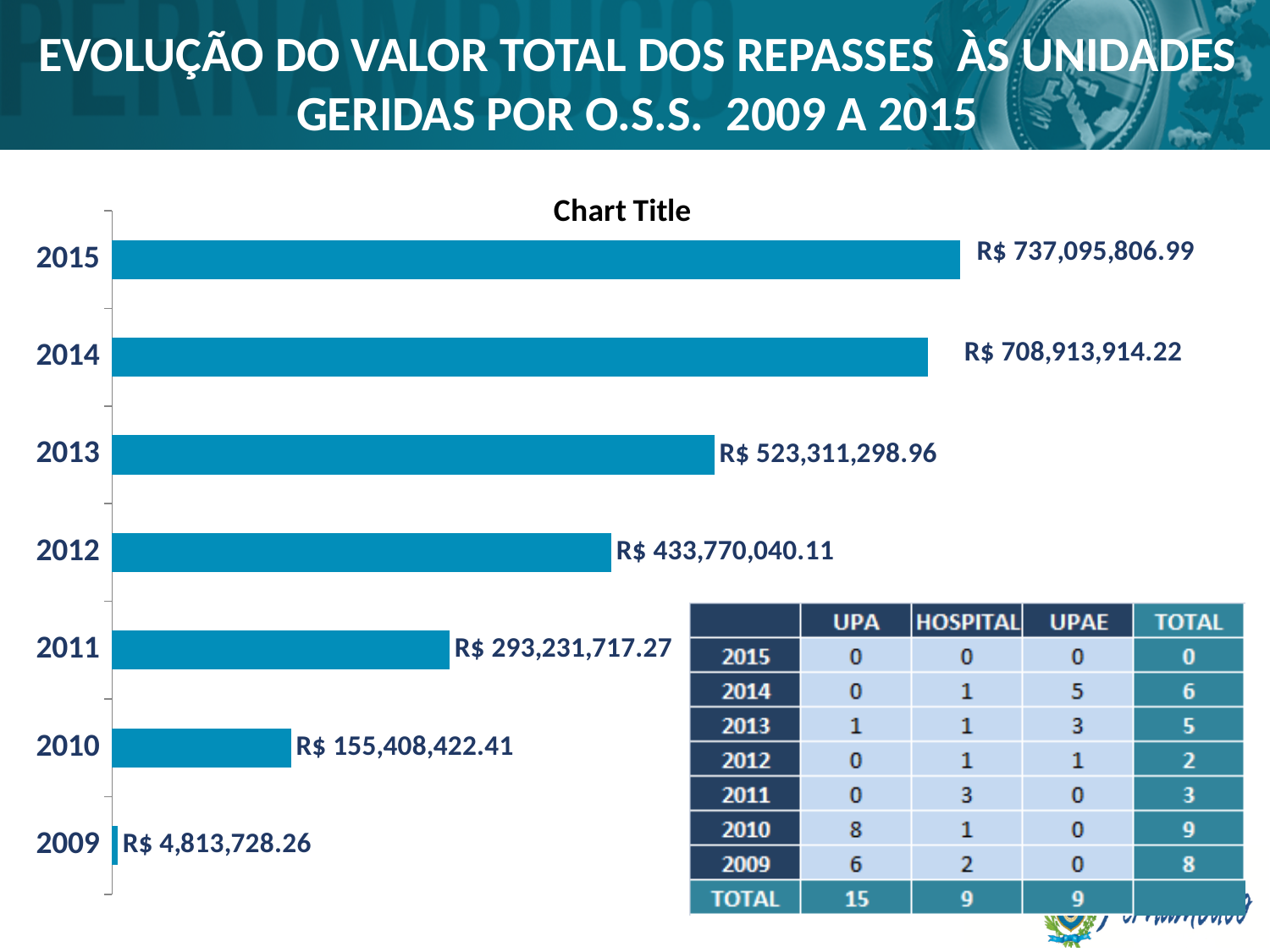
What is the value for 2010? R$ 155,408,422.41 What is the difference between the values for 2013 and 2012? R$ 89,541,258.85 Which is larger, the value for 2011 or the value for 2010? 2011 What is the value for 2009? R$ 4,813,728.26 Do the values rise or fall from 2009 to 2015? Rise What is the value for 2012? R$ 433,770,040.11 What is the difference between the values for 2015 and 2014? R$ 28,181,892.77 How many years are shown in the chart? 7 What kind of chart is shown on the slide? Bar chart Which year has the lowest value? 2009 Which year has the highest value? 2015 What is the value for 2015? R$ 737,095,806.99